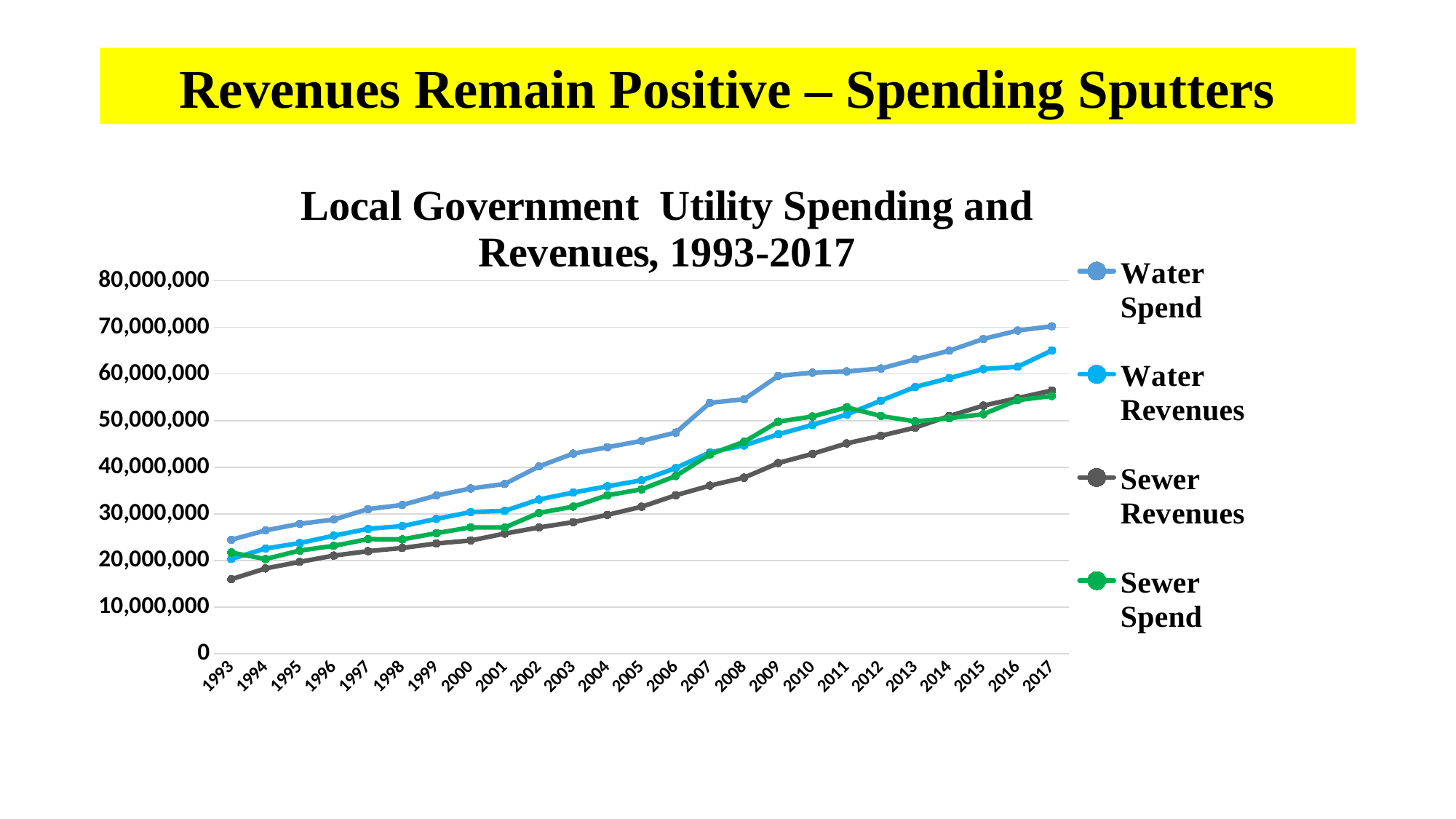
Which series is shown in green in the legend? Sewer Spend Which series has the highest value in 2017? Water Spend Is the value for Water Spend in 2017 greater or less than 60,000,000? greater Does Water Spend generally rise or fall from 1993 to 2017? Rise What kind of chart is shown on the slide? Line chart Which series has the lowest value in 1993? Sewer Revenues How many years are plotted along the x axis? 25 Is the value for Water Revenues in 2017 greater or less than 60,000,000? greater In 2010, which is larger: Water Spend or Water Revenues? Water Spend What is the title of the chart? Local Government Utility Spending and Revenues, 1993-2017 How many series does the legend list? 4 Is the value for Sewer Revenues in 1993 greater or less than 20,000,000? less